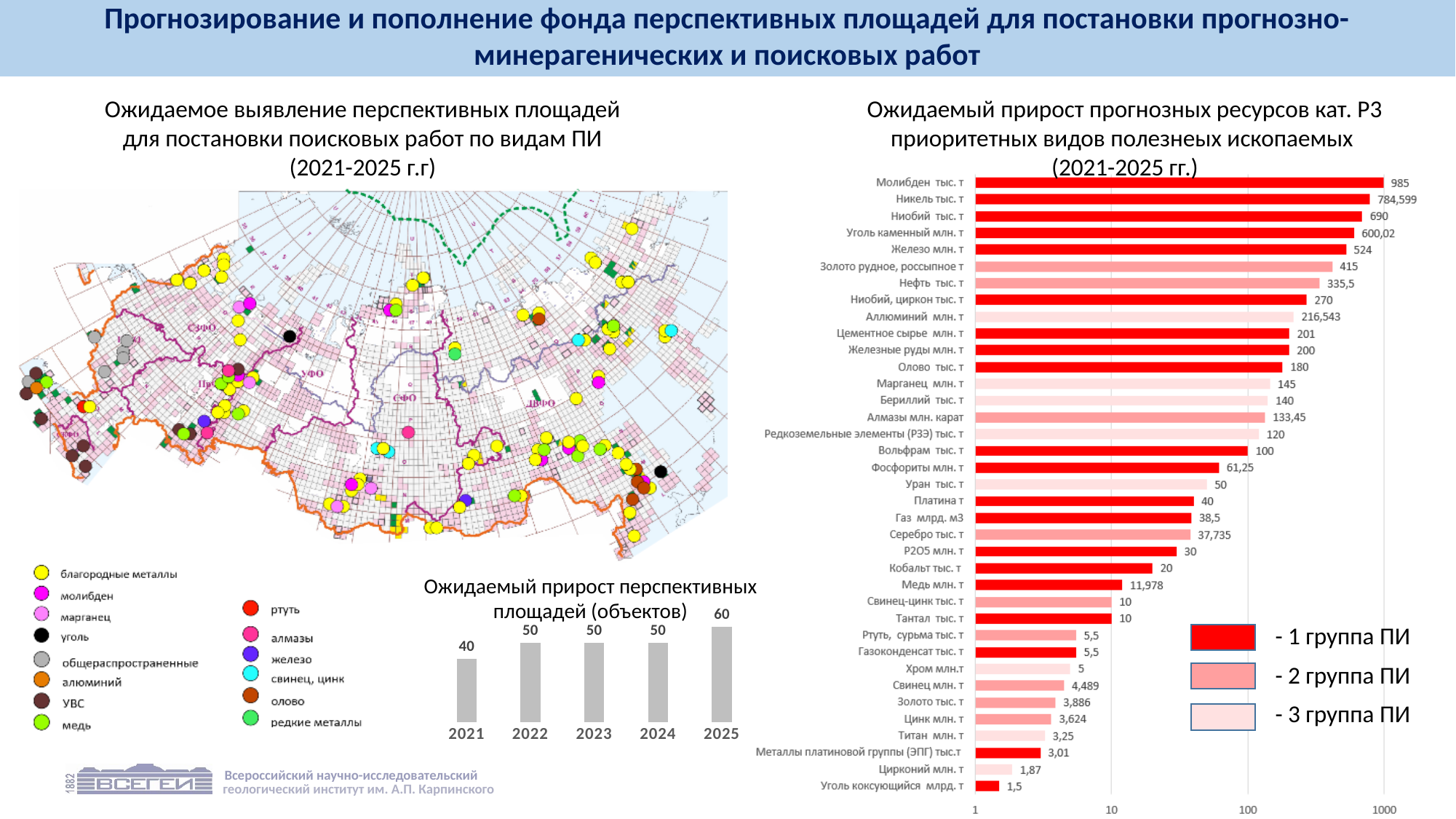
On the chart 'Ожидаемый прирост перспективных площадей (объектов)', what is the difference between the values for 2025 and 2021? 20 What kind of chart is 'Ожидаемый прирост прогнозных ресурсов кат. Р3 приоритетных видов полезных ископаемых (2021-2025 гг.)'? bar chart On the chart 'Ожидаемый прирост прогнозных ресурсов кат. Р3', which is larger: the value for Платина т or the value for Газ млрд. м3? Платина т On the chart 'Ожидаемый прирост прогнозных ресурсов кат. Р3', what is the value for Никель тыс. т? 784,599 On the chart 'Ожидаемый прирост прогнозных ресурсов кат. Р3', which category has the lowest value? Уголь коксующийся млрд. т On the chart 'Ожидаемый прирост перспективных площадей (объектов)', what is the value for 2025? 60 On the chart 'Ожидаемый прирост прогнозных ресурсов кат. Р3', how many groups does the legend list? 3 On the chart 'Ожидаемый прирост перспективных площадей (объектов)', do the values generally rise or fall from 2021 to 2025? rise On the chart 'Ожидаемый прирост перспективных площадей (объектов)', which year has the lowest value? 2021 On the chart 'Ожидаемый прирост прогнозных ресурсов кат. Р3', which category has the highest value? Молибден тыс. т On the chart 'Ожидаемый прирост перспективных площадей (объектов)', how many years are shown on the x axis? 5 On the chart 'Ожидаемый прирост прогнозных ресурсов кат. Р3', what is the value for Алмазы млн. карат? 133,45